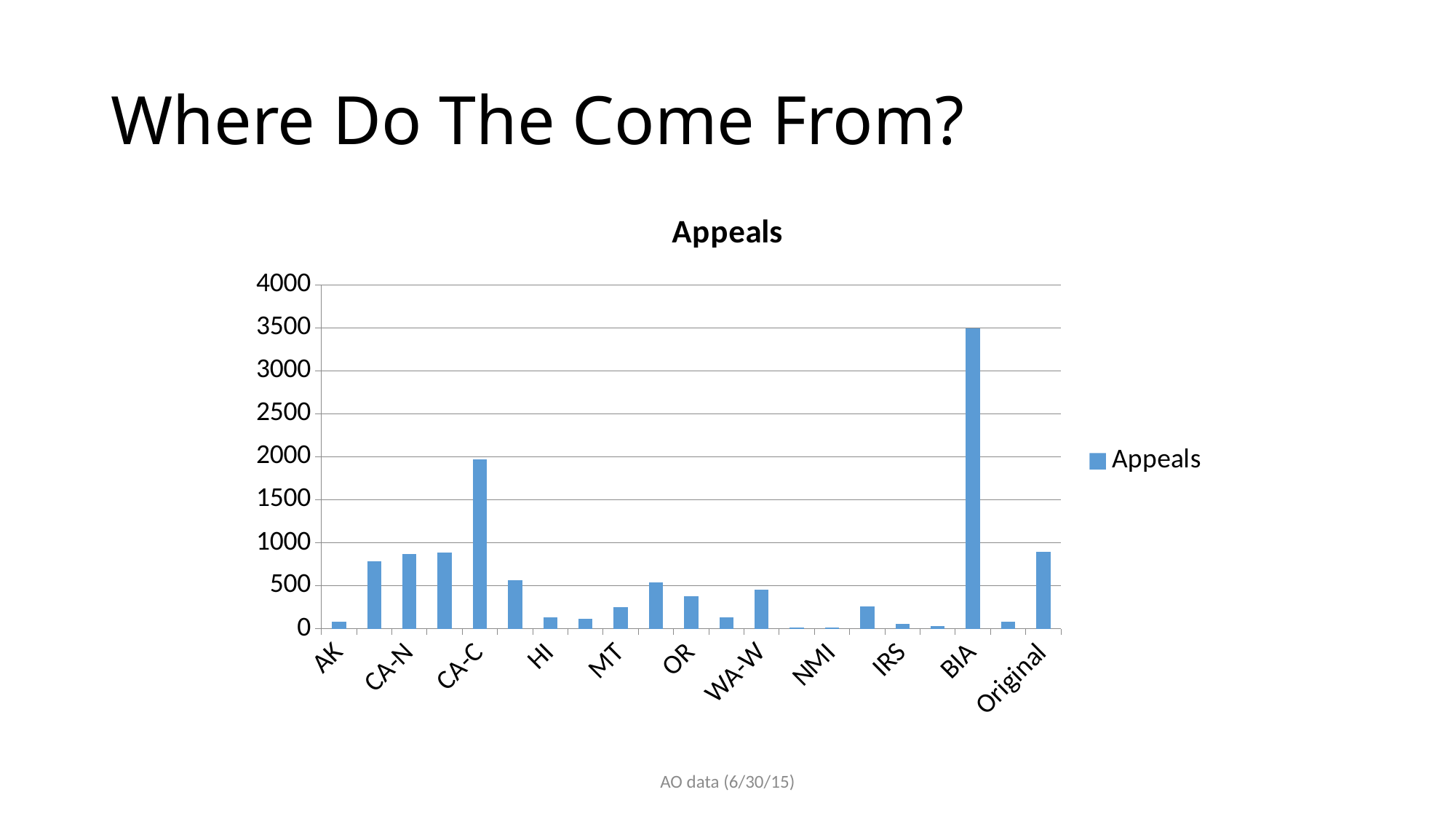
Which category has the highest number of appeals? BIA Which is larger, the value for CA-C or the value for Original? CA-C Which is larger, the value for BIA or the value for CA-C? BIA Is the value for Original greater or less than 1000? less Is the value for BIA greater or less than 3000? greater Is the value for CA-N greater or less than 500? greater What kind of chart is shown on the slide? bar chart Which is larger, the value for CA-N or the value for HI? CA-N What is the title of the chart? Appeals How many series does the legend list? 1